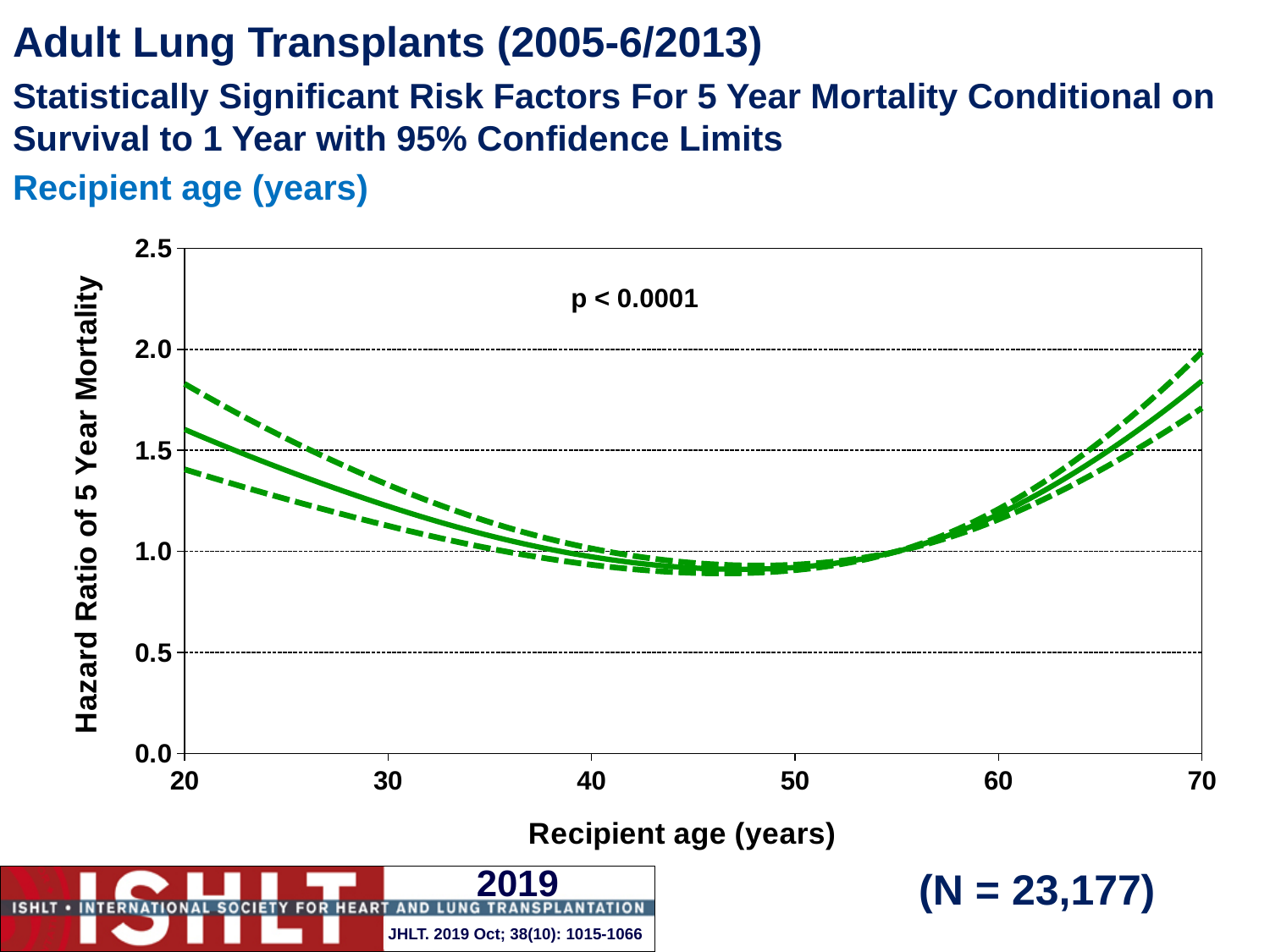
What p-value is printed on the chart? p < 0.0001 Does the hazard ratio rise or fall as recipient age increases from 55 to 70? rise Is the hazard ratio (solid line) at recipient age 20 greater or less than 1.5? greater Does the hazard ratio rise or fall as recipient age increases from 20 to 45? fall Is the hazard ratio (solid line) at recipient age 70 greater or less than 1.5? greater Is the hazard ratio (solid line) at recipient age 45 greater or less than 1.0? less What is the label of the y axis? Hazard Ratio of 5 Year Mortality How many lines are plotted on the chart? 3 What kind of chart is shown on the slide? line chart Which recipient age has the higher hazard ratio on the solid line, 20 or 70? 70